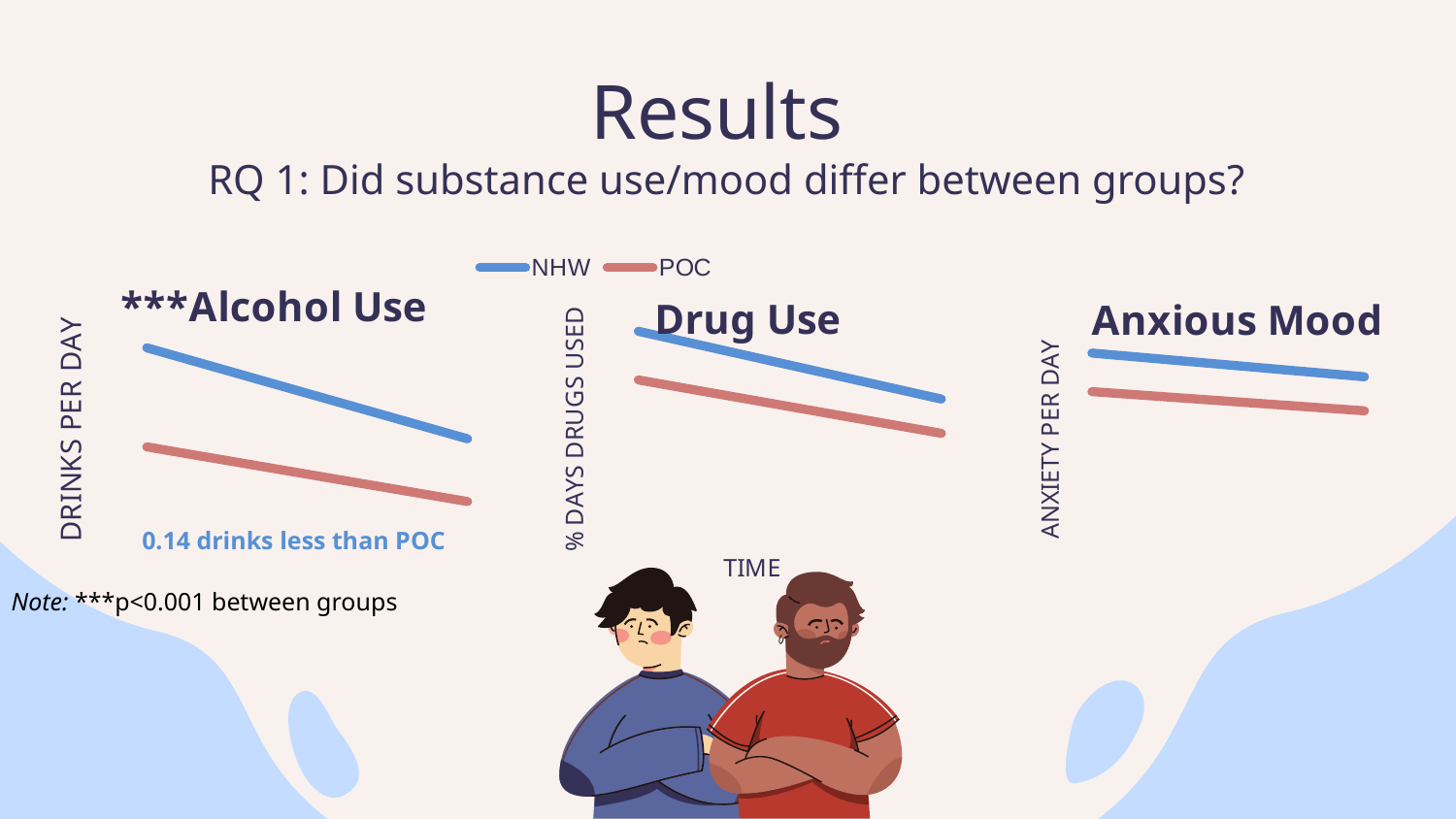
What kind of chart is the Alcohol Use chart? Line chart How many charts are shown on the slide? 3 How many series does the legend list for the charts? 2 What is the y-axis label of the Drug Use chart? % DAYS DRUGS USED In the Drug Use chart, which group has the higher line, NHW or POC? NHW In the Drug Use chart, does the POC line rise or fall over time? Fall In the Alcohol Use chart, which group has the higher line, NHW or POC? NHW In the Anxious Mood chart, which group has the lower line, NHW or POC? POC In the Anxious Mood chart, does the NHW line rise or fall over time? Fall Which colour represents the POC group in the legend? Red In the Alcohol Use chart, does the NHW line rise or fall over time? Fall